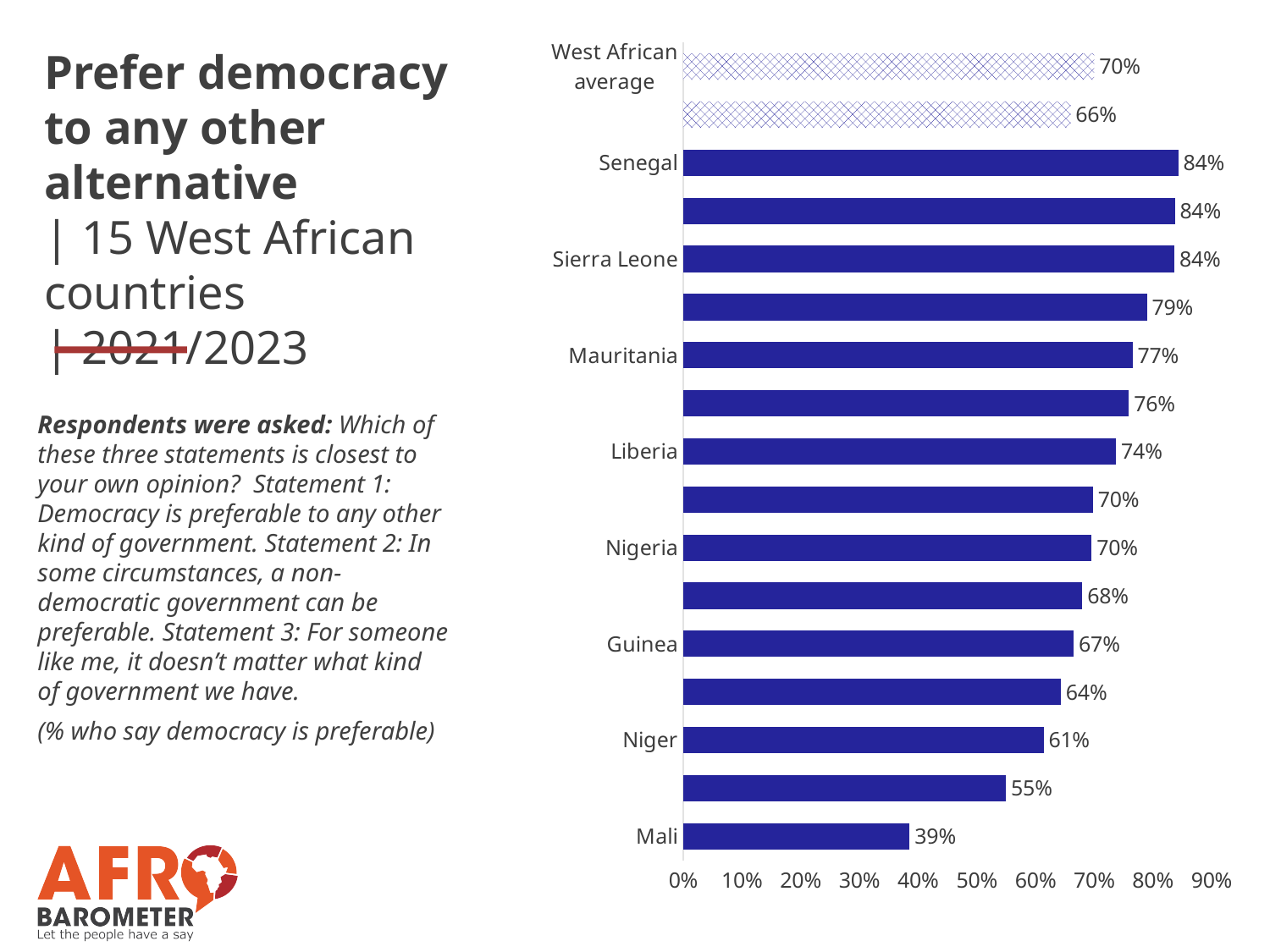
What is the difference between the values for Senegal and Mali? 45 percentage points What is the highest value shown on the chart? 84% What is the value for Guinea? 67% How many bars are plotted on the chart? 17 Which labelled country has the lowest value? Mali What kind of chart is shown on the slide? bar chart What is the value for Niger? 61% What is the value for Mali? 39% Which has a larger value, Liberia or Nigeria? Liberia What is the value for Senegal? 84% What is the value of the first West African average bar? 70% What is the value for Mauritania? 77%